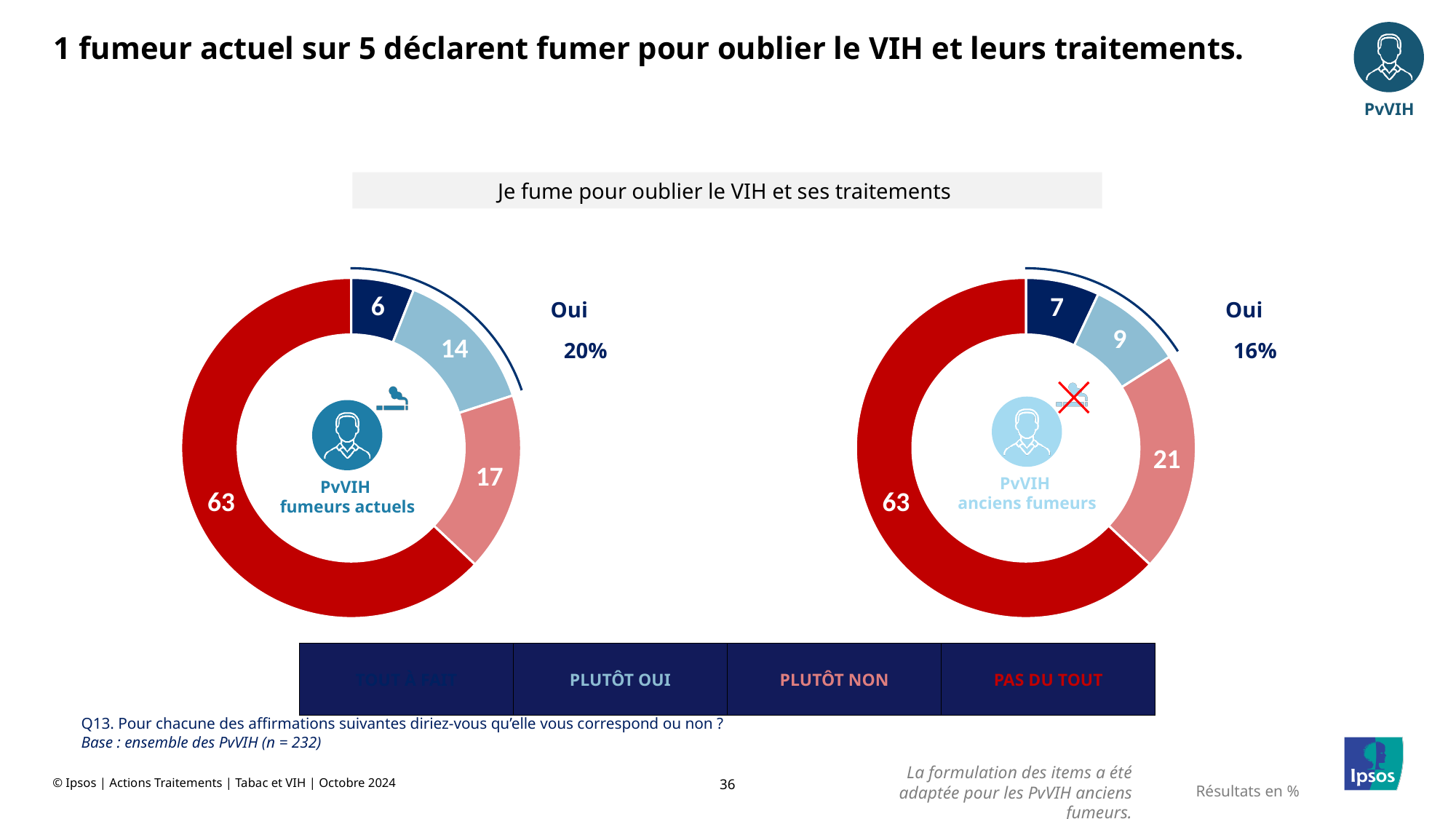
What is the 'Oui' percentage shown next to the right donut chart (PvVIH anciens fumeurs)? 16% In the left donut chart (PvVIH fumeurs actuels), what value is shown for the 'Plutôt oui' segment? 14 In the left donut chart (PvVIH fumeurs actuels), what value is shown for the 'Pas du tout' segment? 63 What type of chart is used on this slide? Donut (pie) chart In the left donut chart (PvVIH fumeurs actuels), which segment has the largest value? Pas du tout How many segments does each donut chart on the slide contain? 4 Which chart has the larger 'Plutôt oui' value, the left (PvVIH fumeurs actuels) or the right (PvVIH anciens fumeurs)? Left (PvVIH fumeurs actuels) What is the difference between the 'Plutôt non' values of the right chart (PvVIH anciens fumeurs) and the left chart (PvVIH fumeurs actuels)? 4 What is the 'Oui' percentage shown next to the left donut chart (PvVIH fumeurs actuels)? 20% In the right donut chart (PvVIH anciens fumeurs), what value is shown for the 'Plutôt oui' segment? 9 In the right donut chart (PvVIH anciens fumeurs), what value is shown for the 'Plutôt non' segment? 21 In the right donut chart (PvVIH anciens fumeurs), which segment has the smallest value? Tout à fait